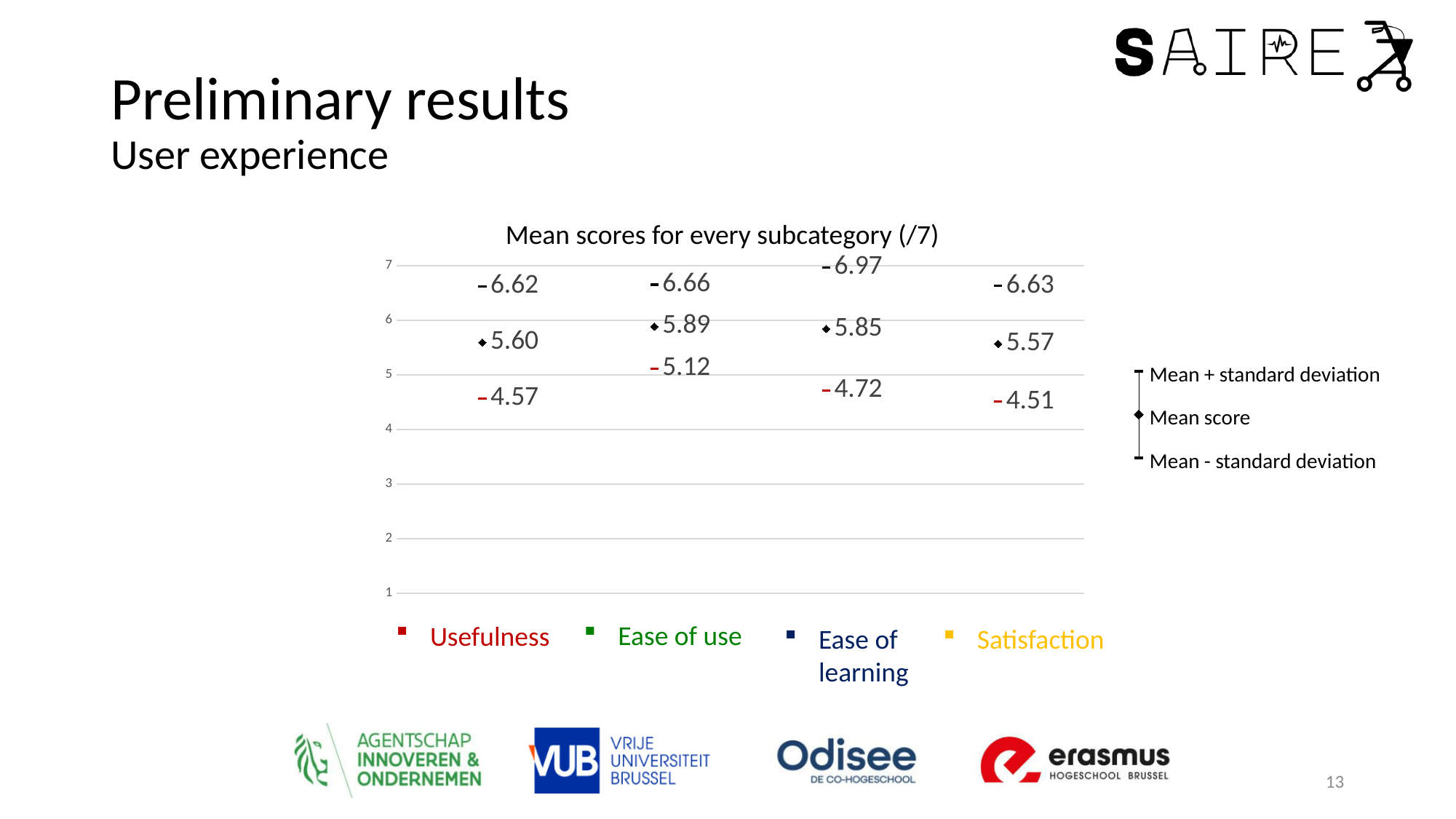
What is the mean score for Ease of use? 5.89 What is the title of the chart? Mean scores for every subcategory (/7) Is the mean score for Ease of learning greater or less than 5? greater What is the mean score for Usefulness? 5.60 How many subcategories are shown in the chart? 4 What is the mean minus standard deviation value for Satisfaction? 4.51 Which subcategory has the highest mean score? Ease of use What does the diamond marker in the chart's legend represent? Mean score What is the difference between the mean plus standard deviation and the mean minus standard deviation for Usefulness? 2.05 Which has a higher mean score, Usefulness or Satisfaction? Usefulness Which subcategory has the lowest mean minus standard deviation value? Satisfaction What is the mean plus standard deviation value for Ease of learning? 6.97